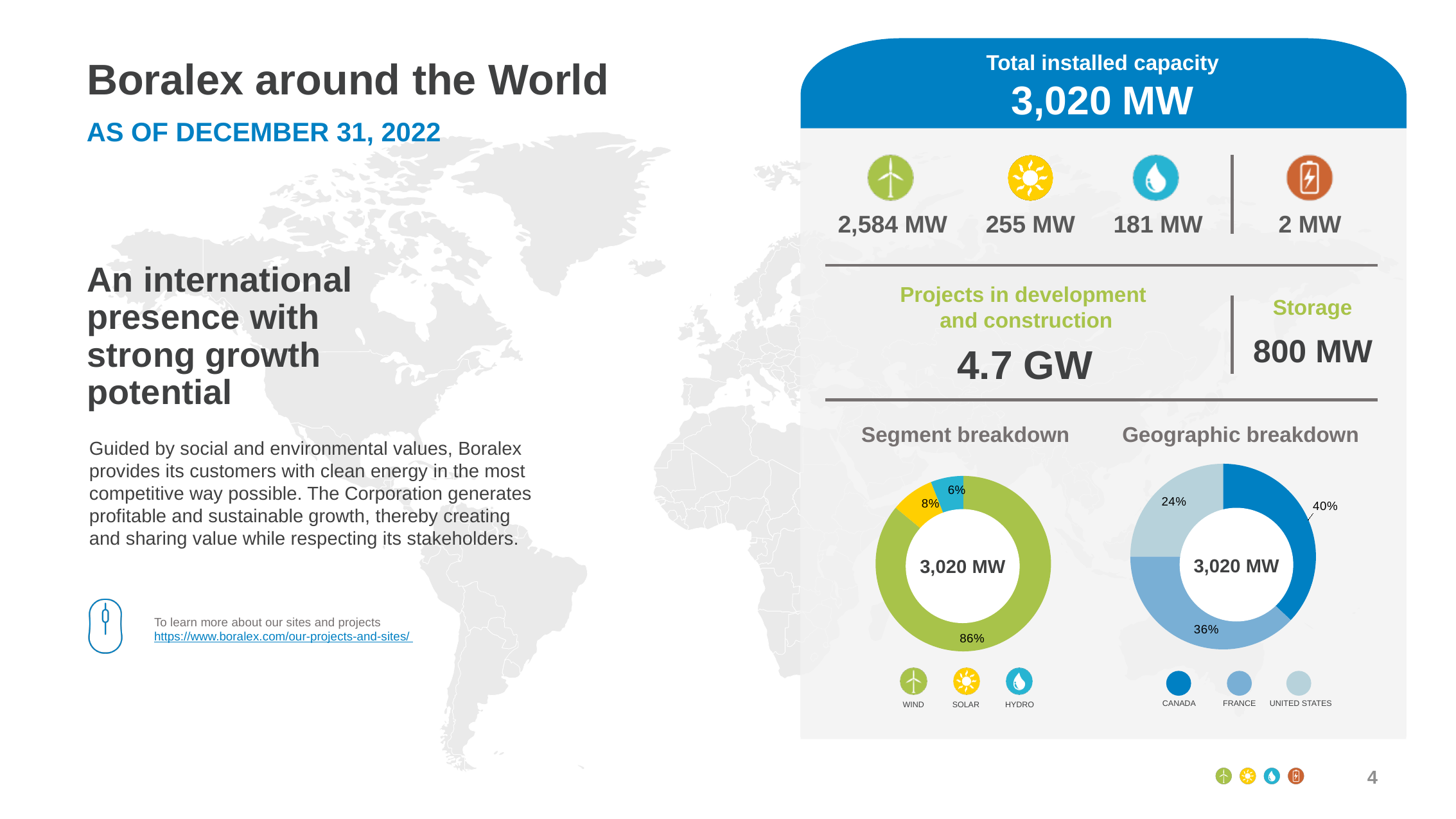
In the Geographic breakdown chart, what share does the United States account for? 24% In the Segment breakdown chart, which segment has the largest share? Wind In the Segment breakdown chart, what share does Hydro account for? 6% What type of chart is the Segment breakdown chart? Donut chart In the Geographic breakdown chart, what is the difference in percentage points between Canada's share and the United States' share? 16 In the Segment breakdown chart, which is larger, the Solar share or the Hydro share? Solar In the Geographic breakdown chart, which country has the smallest share? United States How many categories does the Geographic breakdown chart's legend list? 3 In the Segment breakdown chart, what share does Wind account for? 86% In the Segment breakdown chart, what share does Solar account for? 8% In the Geographic breakdown chart, what share does France account for? 36% In the Geographic breakdown chart, what share does Canada account for? 40%